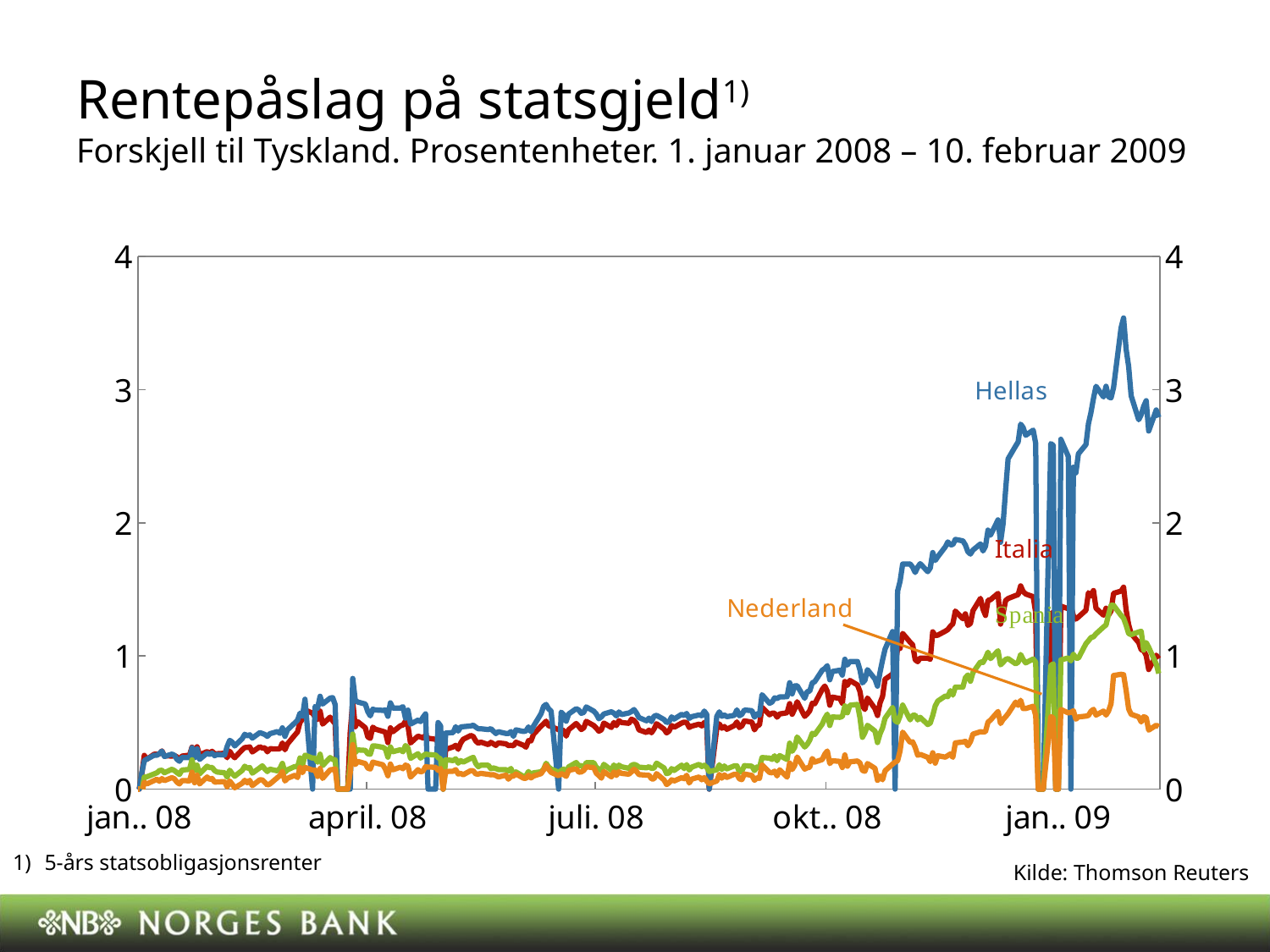
What source is cited for the chart? Thomson Reuters Is the peak value for Italia greater or less than 2? less Is the peak value for Hellas greater or less than 3? greater What is the title of the chart on the slide? Rentepåslag på statsgjeld Is the value for Nederland at the end of the period greater or less than 1? less At the end of the period, which is higher, Hellas or Italia? Hellas What kind of chart is shown on the slide? line chart Which country's series reaches the highest value on the chart? Hellas Which country's series is the lowest at the end of the period (February 2009)? Nederland Around October 2008, which is higher, Italia or Nederland? Italia How many countries (series) are labelled on the chart? 4 Do the spreads generally rise or fall from January 2008 to January 2009? rise